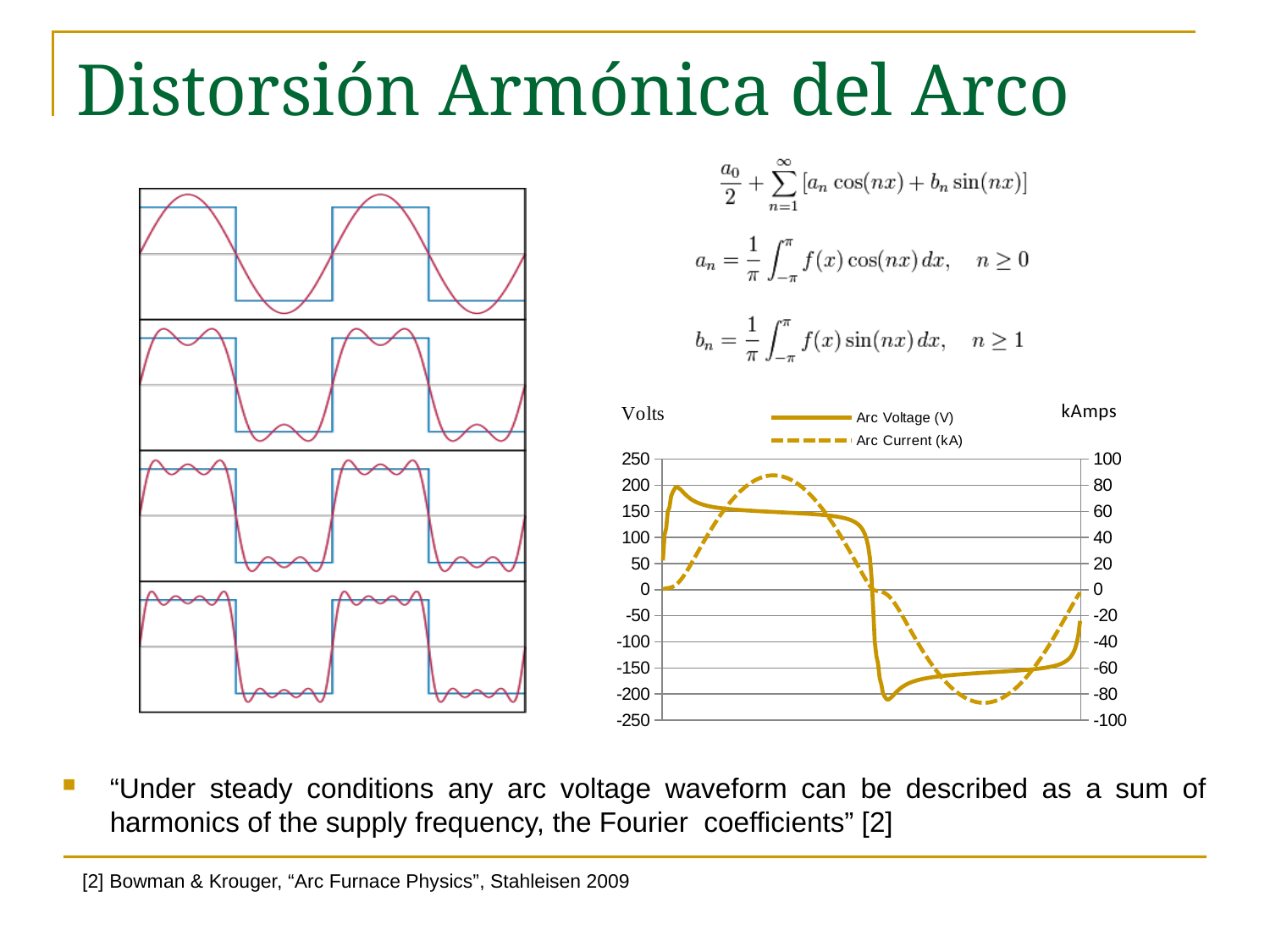
In the chart on the right, is the peak value of Arc Current (kA) greater or less than 100 on the right axis? less In the chart on the right, which series is drawn with a dashed line? Arc Current (kA) In the chart on the right, is the peak value of Arc Current (kA) greater or less than 60 on the right axis? greater What is the maximum value shown on the left axis of the chart on the right? 250 What is the minimum value shown on the right axis of the chart on the right? -100 What kind of chart is the chart on the right of the slide? line chart In the chart on the right, is the peak value of Arc Voltage (V) greater or less than 250 on the left axis? less How many series does the legend of the chart on the right list? 2 What are the two series named in the legend of the chart on the right? Arc Voltage (V) and Arc Current (kA)